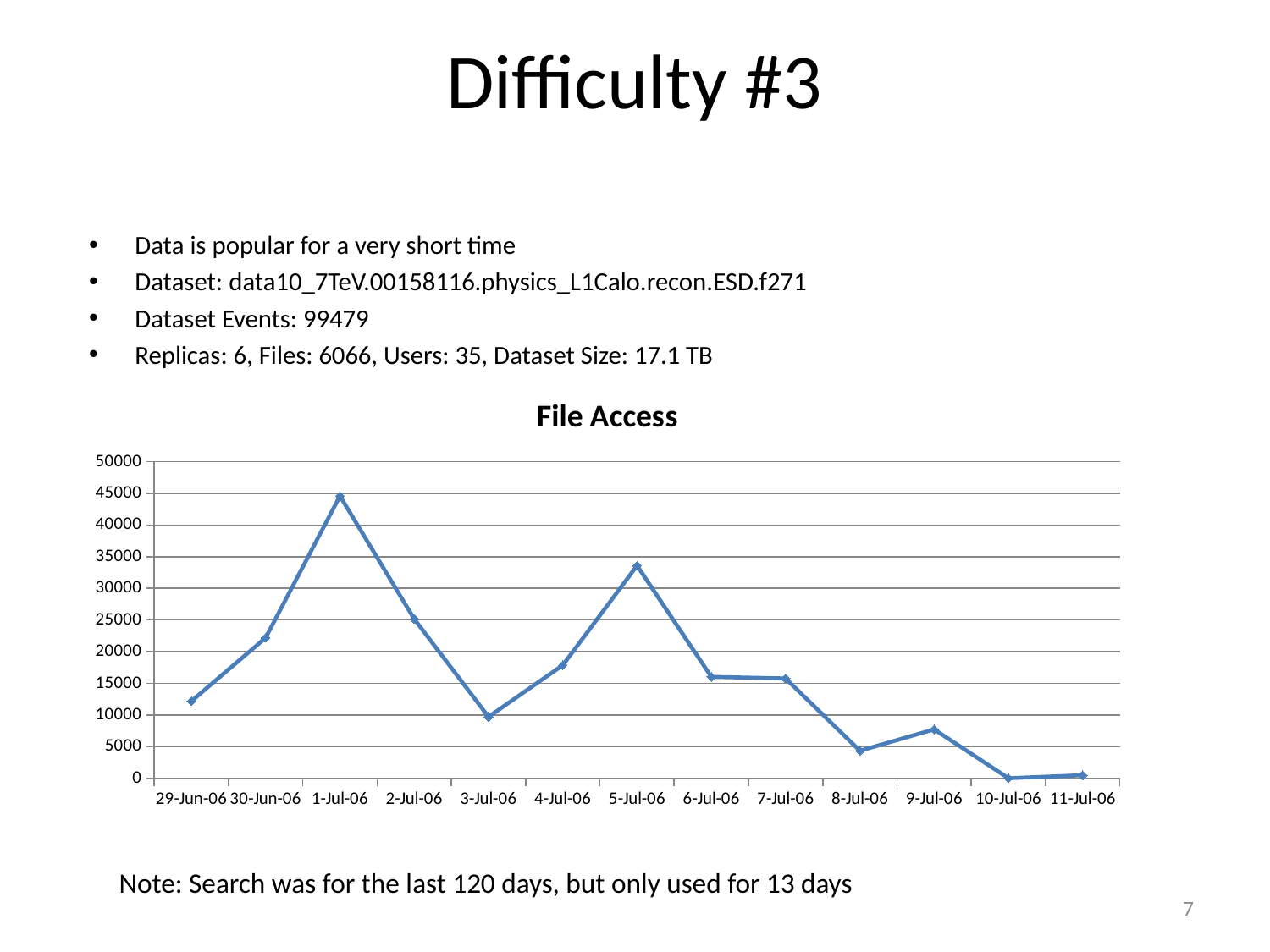
Which date has the larger value, 30-Jun-06 or 2-Jul-06? 2-Jul-06 What kind of chart is shown on the slide? line chart Is the value for 5-Jul-06 greater or less than 30000? greater Is the value for 3-Jul-06 greater or less than 15000? less Do the values rise or fall from 5-Jul-06 to 8-Jul-06? fall What is the title of the chart? File Access On which date does the File Access chart reach its highest value? 1-Jul-06 Do the values rise or fall from 29-Jun-06 to 1-Jul-06? rise Is the value for 1-Jul-06 greater or less than 40000? greater How many dates are plotted on the x axis of the File Access chart? 13 Which date has the larger value, 4-Jul-06 or 9-Jul-06? 4-Jul-06